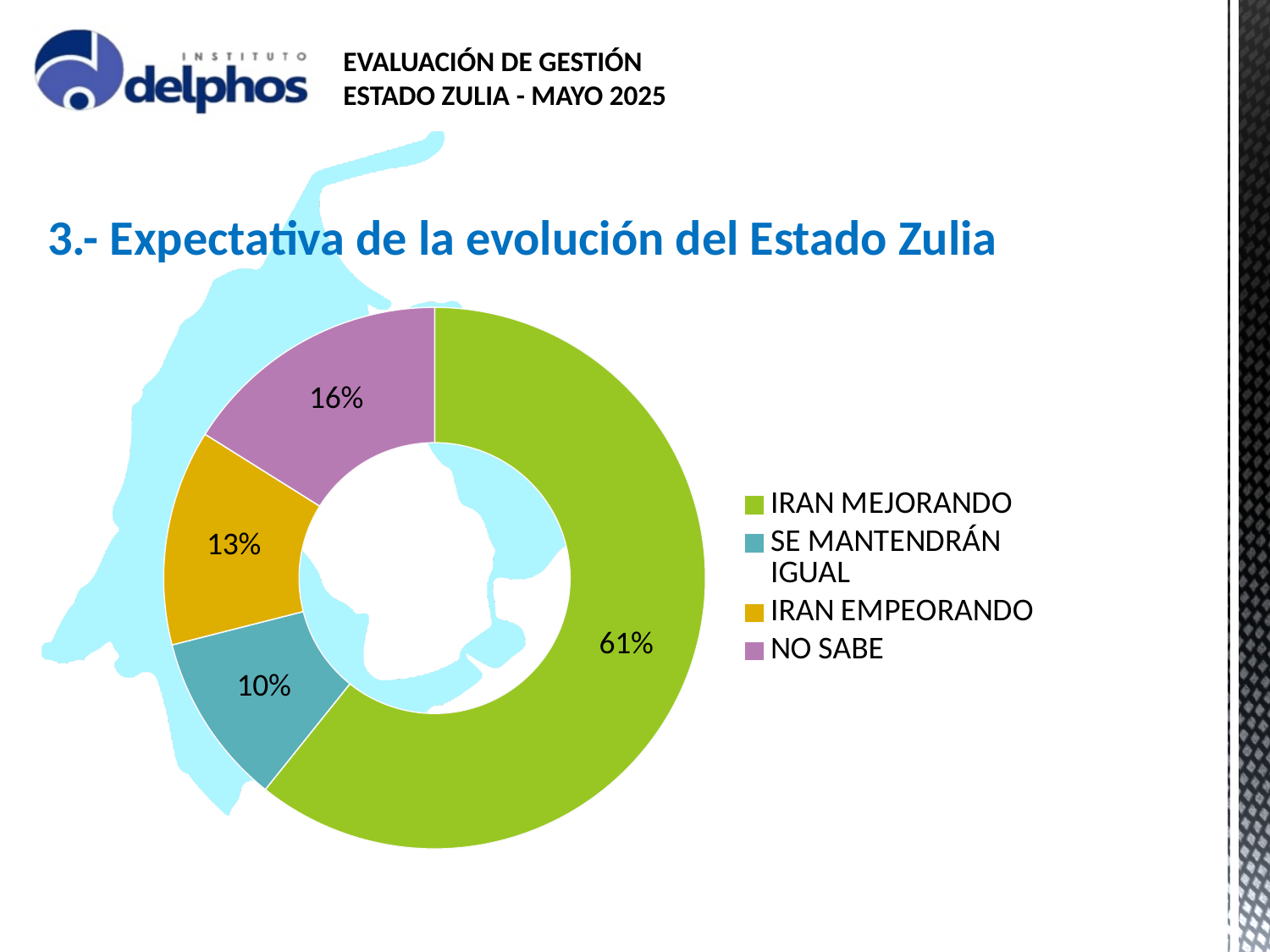
What is the combined share of IRAN EMPEORANDO and NO SABE? 29% What colour represents the NO SABE category in the chart? Purple Which category has the smallest share of the chart? SE MANTENDRÁN IGUAL How many categories does the chart show? 4 What is the difference in percentage points between IRAN MEJORANDO and NO SABE? 45 Which category has the largest share of the chart? IRAN MEJORANDO What percentage of respondents answered SE MANTENDRÁN IGUAL? 10% Which is larger, the share for IRAN EMPEORANDO or the share for SE MANTENDRÁN IGUAL? IRAN EMPEORANDO What kind of chart is shown on the slide? Pie chart (doughnut) What percentage of respondents said the Estado Zulia will be improving (IRAN MEJORANDO)? 61% What percentage of respondents answered NO SABE? 16% What percentage of respondents answered IRAN EMPEORANDO? 13%